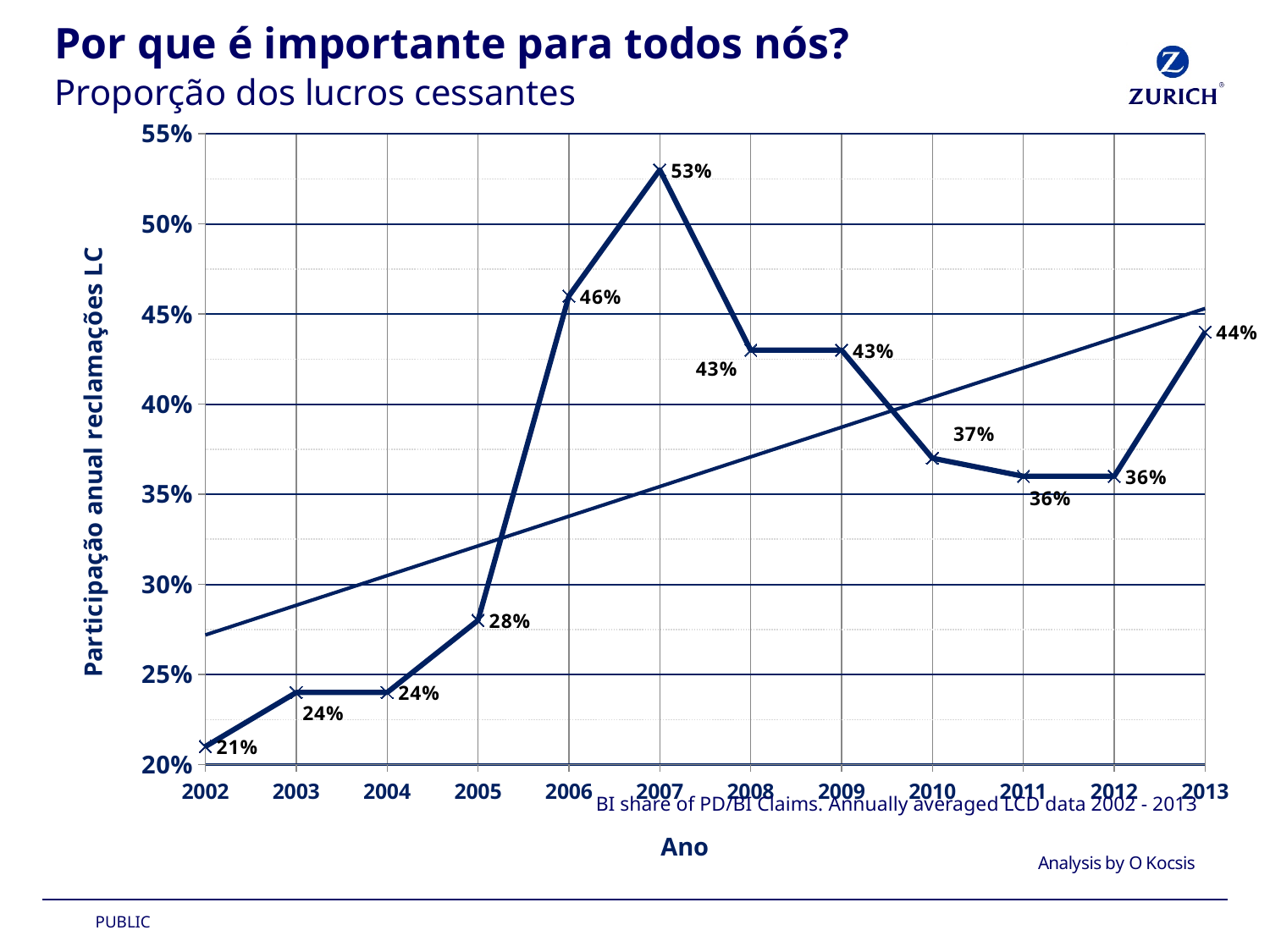
What is the value for 2007? 53% What is the difference between the values for 2007 and 2006? 7% What is the value for 2010? 37% What kind of chart is shown? line chart What is the label of the x axis? Ano Which is larger, the value for 2013 or the value for 2012? 2013 How many years are plotted on the x axis? 12 Which year has the lowest value? 2002 Which year has the highest value? 2007 Is the value for 2006 greater or less than 45%? greater What is the value for 2013? 44% What is the value for 2002? 21%